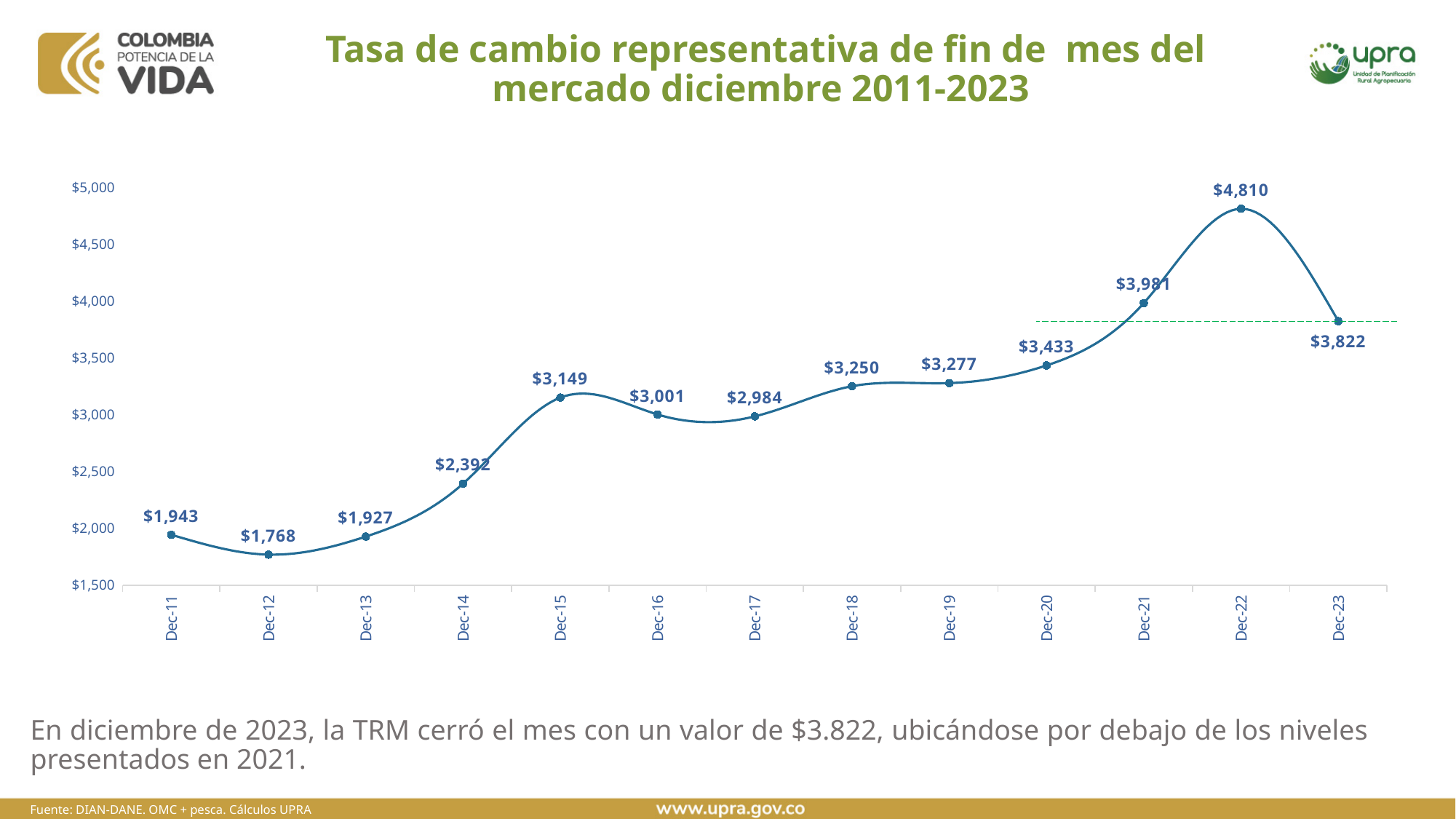
Do the values rise or fall from Dec-22 to Dec-23? fall What is the difference between the values for Dec-22 and Dec-23? $988 How many data points are plotted on the chart? 13 What is the value for Dec-15? $3,149 Is the value for Dec-14 greater or less than $2,500? less What is the value for Dec-12? $1,768 What kind of chart is shown on the slide? line chart What is the value for Dec-22? $4,810 Which point has the highest value? Dec-22 What is the difference between the values for Dec-21 and Dec-20? $548 Which is larger, the value for Dec-16 or the value for Dec-17? Dec-16 Which point has the lowest value? Dec-12